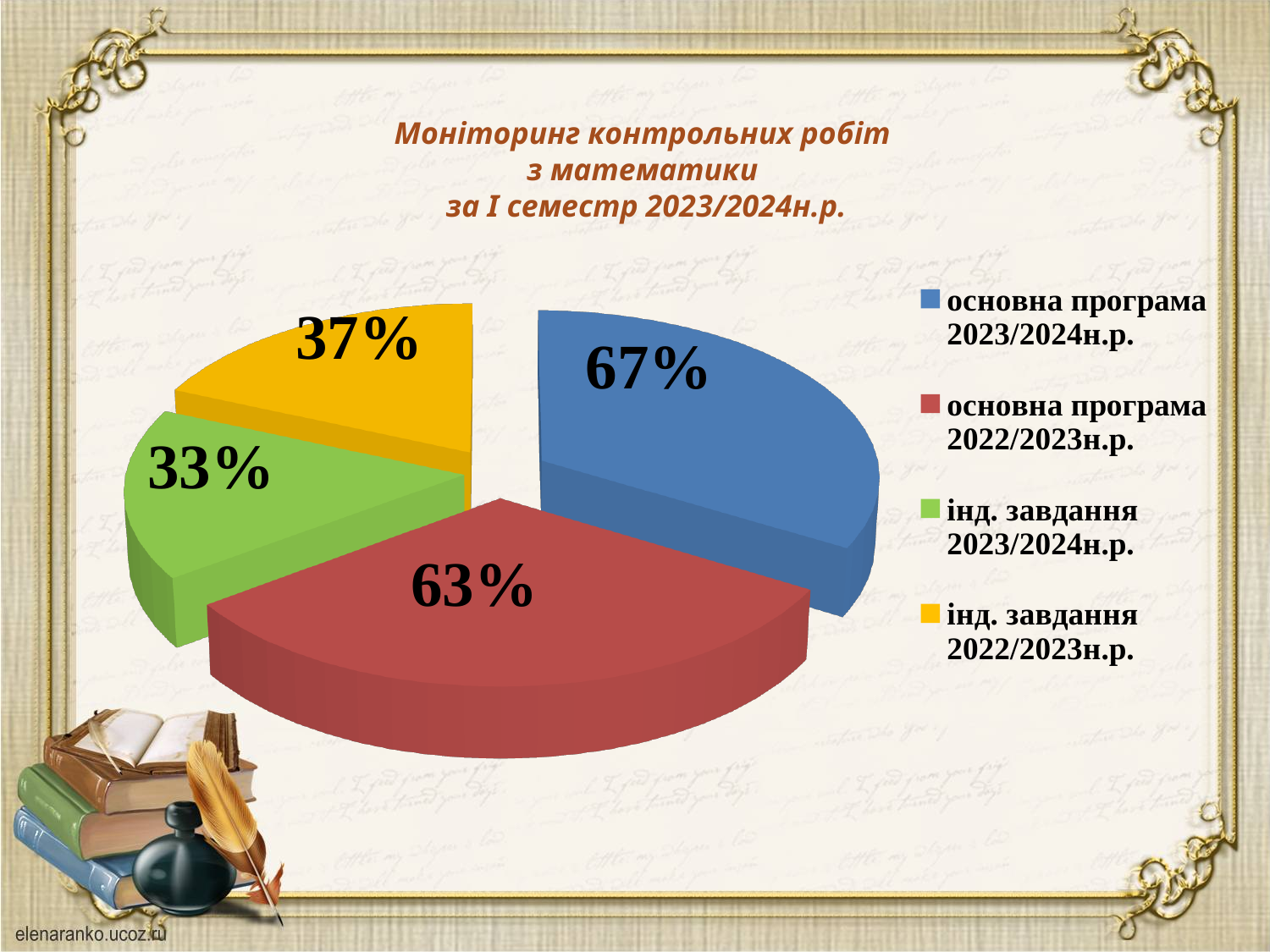
What is the value labelled for 'інд. завдання 2022/2023н.р.'? 37% What is the difference between the values for 'основна програма 2023/2024н.р.' and 'основна програма 2022/2023н.р.'? 4% Which category has the highest value in the pie chart? основна програма 2023/2024н.р. What is the value labelled for 'основна програма 2022/2023н.р.'? 63% What is the difference between the values for 'інд. завдання 2022/2023н.р.' and 'інд. завдання 2023/2024н.р.'? 4% Which category has the lowest value in the pie chart? інд. завдання 2023/2024н.р. What type of chart is shown on the slide? Pie chart What is the value labelled for 'інд. завдання 2023/2024н.р.'? 33% What colour is the slice for 'основна програма 2022/2023н.р.'? Red What is the value labelled for 'основна програма 2023/2024н.р.'? 67% Which is larger: the value for 'інд. завдання 2023/2024н.р.' or 'інд. завдання 2022/2023н.р.'? інд. завдання 2022/2023н.р. How many slices does the pie chart have? 4